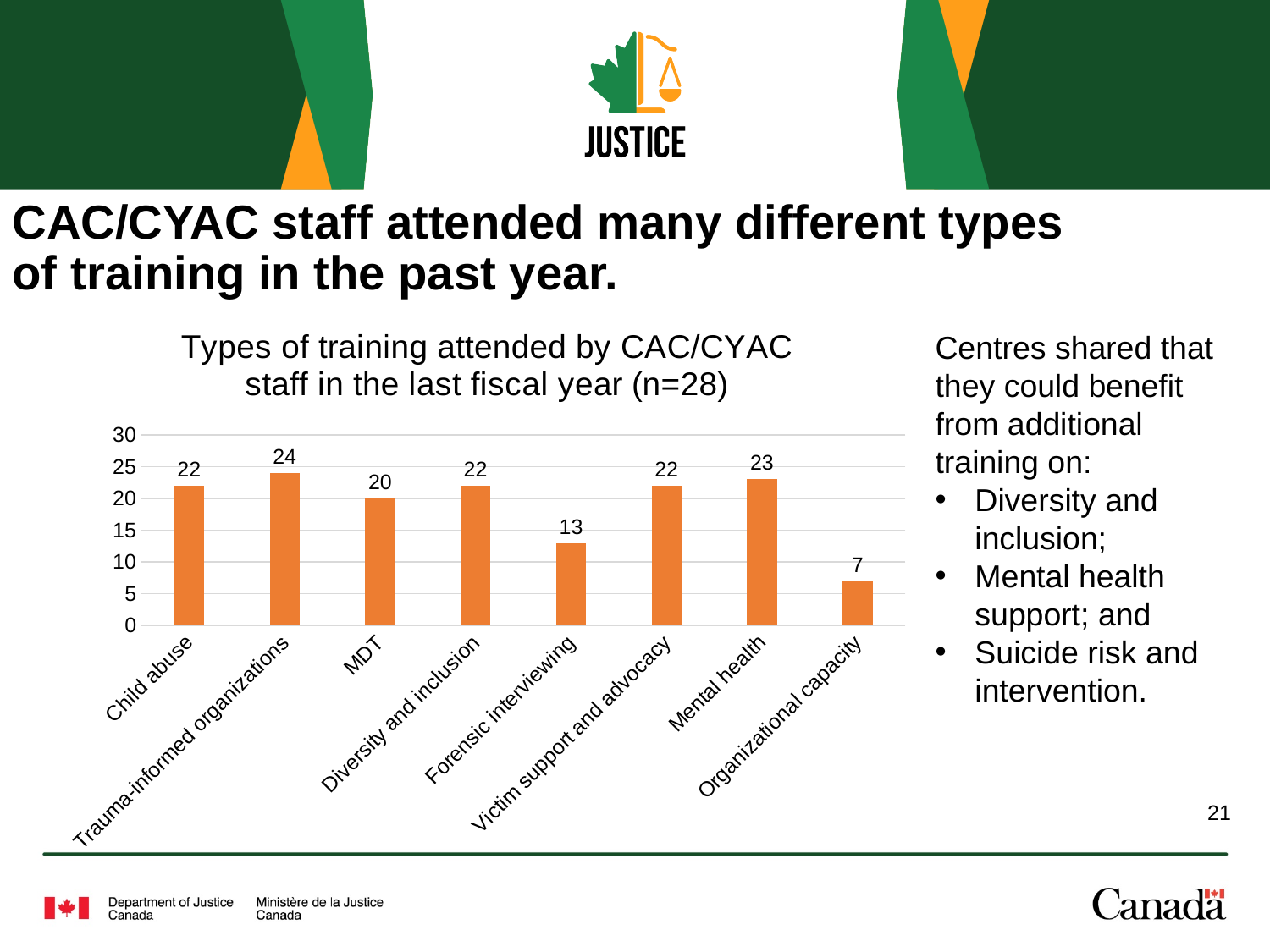
What is the value for Forensic interviewing? 13 Is the value for Forensic interviewing greater or less than 15? less Which type of training has the lowest value? Organizational capacity Which is larger, the value for MDT or the value for Mental health? Mental health What is the title of the chart? Types of training attended by CAC/CYAC staff in the last fiscal year (n=28) What is the value for Mental health? 23 What kind of chart is shown on the slide? bar chart What is the difference between the values for Trauma-informed organizations and Organizational capacity? 17 How many types of training are shown on the chart? 8 What is the value for Trauma-informed organizations? 24 What is the value for Organizational capacity? 7 Which type of training has the highest value? Trauma-informed organizations